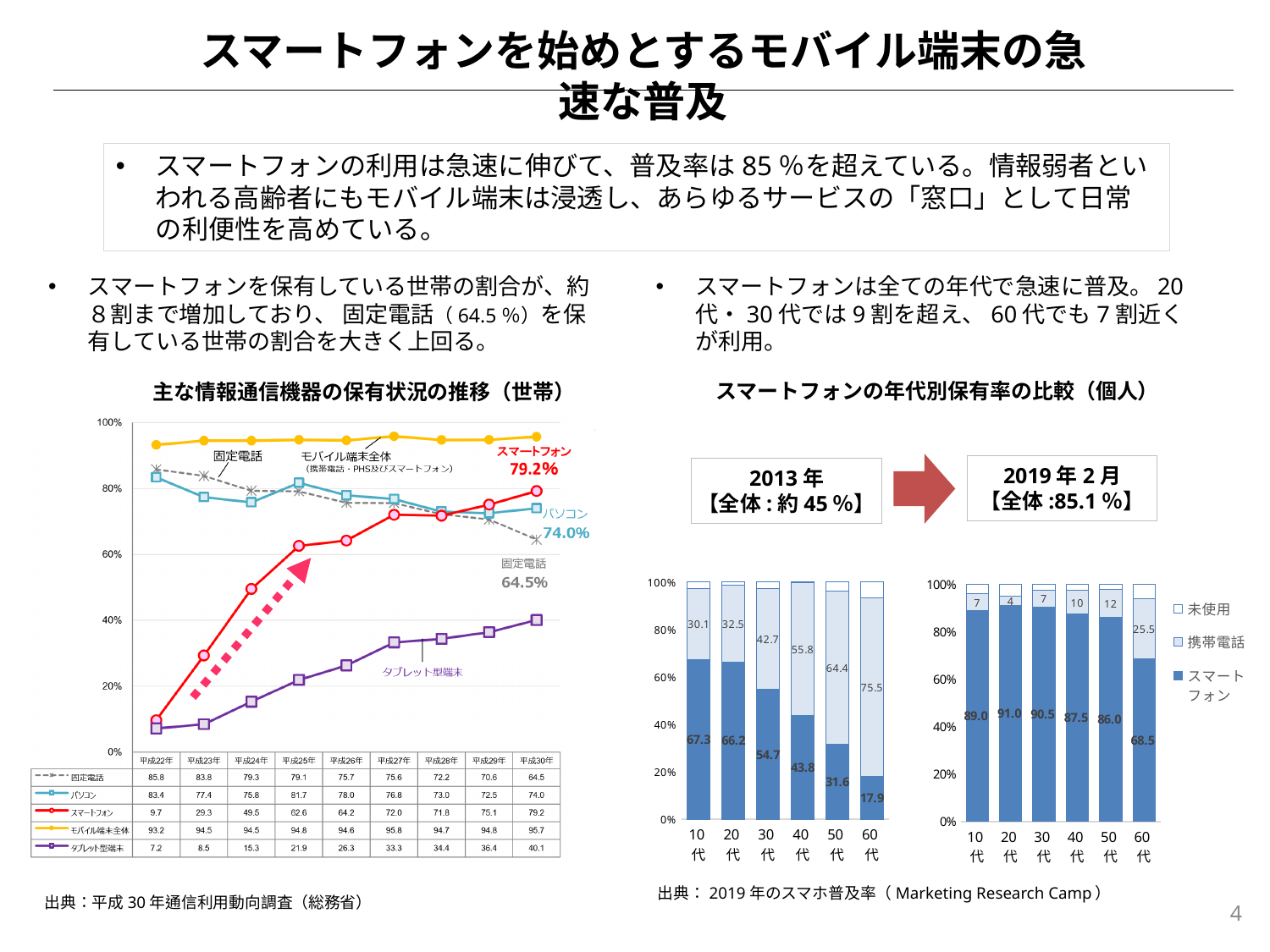
In the line chart 主な情報通信機器の保有状況の推移（世帯）, which series has the lowest value in 平成22年? タブレット型端末 What kind of chart is used for スマートフォンの年代別保有率の比較（個人）? stacked bar chart In the line chart 主な情報通信機器の保有状況の推移（世帯）, what is the value for 固定電話 in 平成22年? 85.8 In the 2019年2月 bar chart of スマートフォンの年代別保有率の比較（個人）, what is the 携帯電話 value for 60代? 25.5 In the 2013年 bar chart of スマートフォンの年代別保有率の比較（個人）, what is the スマートフォン value for 60代? 17.9 How many series does the legend of the line chart 主な情報通信機器の保有状況の推移（世帯） list? 5 In the line chart 主な情報通信機器の保有状況の推移（世帯）, which series has the highest value in 平成30年? モバイル端末全体 In the 2013年 bar chart of スマートフォンの年代別保有率の比較（個人）, which is larger for 40代: スマートフォン or 携帯電話? 携帯電話 In the line chart 主な情報通信機器の保有状況の推移（世帯）, does the value for 固定電話 rise or fall from 平成22年 to 平成30年? fall In the line chart 主な情報通信機器の保有状況の推移（世帯）, what is the value for スマートフォン in 平成30年? 79.2 In the 2019年2月 bar chart of スマートフォンの年代別保有率の比較（個人）, which age group has the highest スマートフォン value? 20代 In the line chart 主な情報通信機器の保有状況の推移（世帯）, what is the difference between スマートフォン and 固定電話 in 平成30年? 14.7